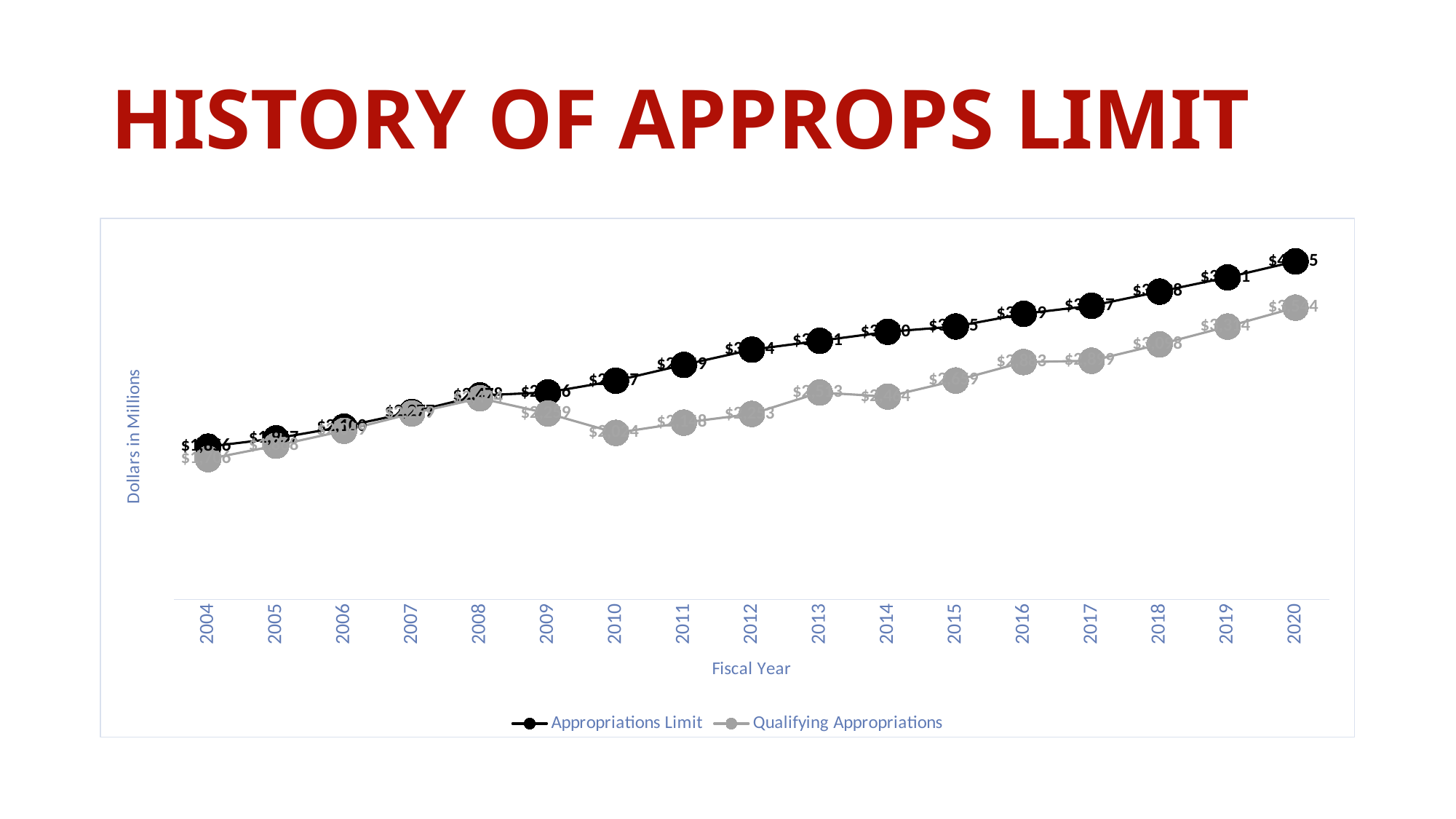
In 2010, which series is higher: Appropriations Limit or Qualifying Appropriations? Appropriations Limit How many series does the legend list? 2 Which fiscal year has the highest Appropriations Limit? 2020 Do Qualifying Appropriations rise or fall from 2009 to 2010? Fall What is the label of the y axis? Dollars in Millions Which fiscal year has the highest Qualifying Appropriations? 2020 Does the Appropriations Limit generally rise or fall from 2004 to 2020? Rise How many fiscal years are plotted along the x axis? 17 What kind of chart is shown on the slide? Line chart In 2020, which series is higher: Appropriations Limit or Qualifying Appropriations? Appropriations Limit Which fiscal year has the lowest Qualifying Appropriations? 2004 Which fiscal year has the lowest Appropriations Limit? 2004